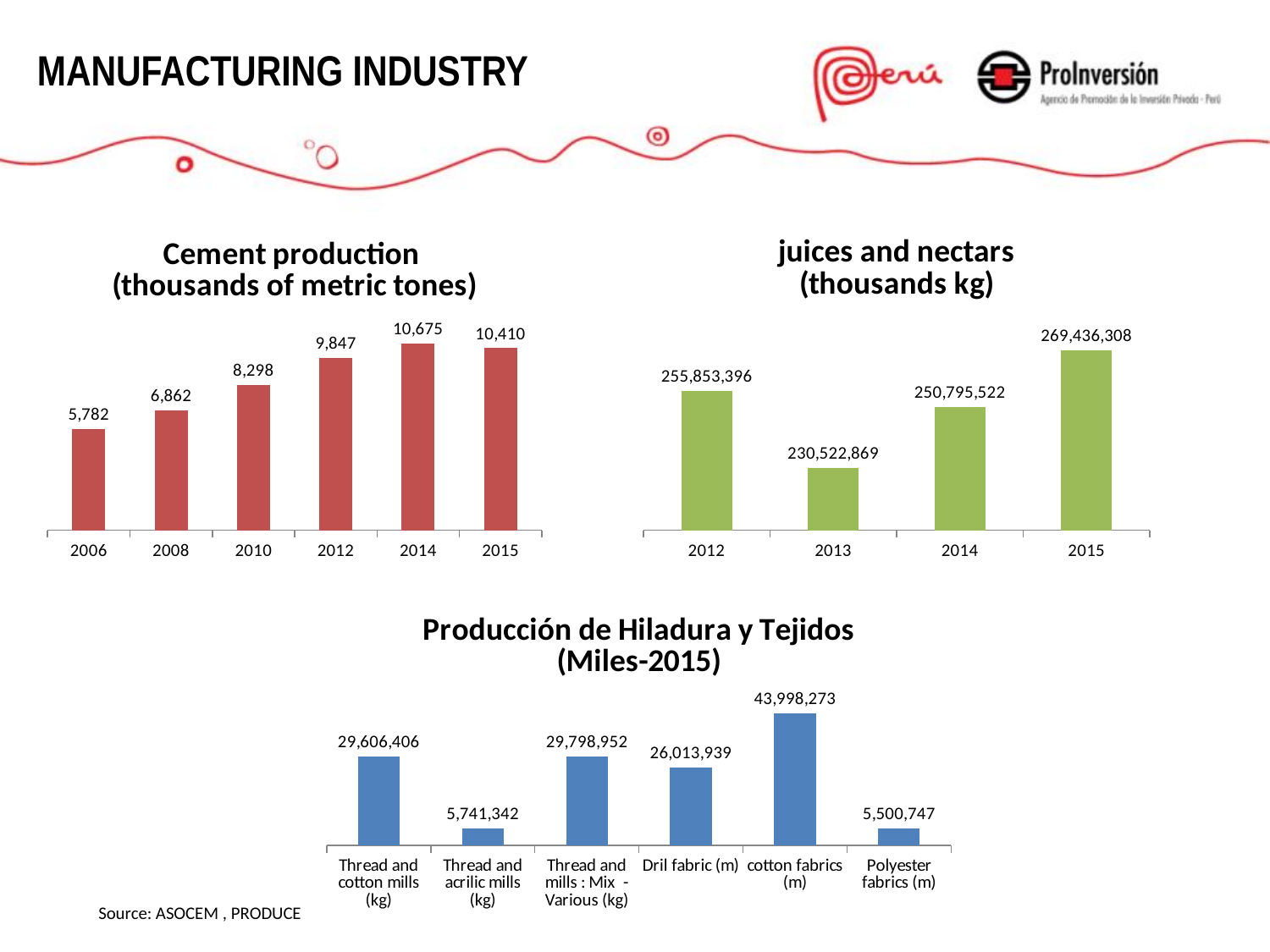
In the Cement production chart, which year has the highest value? 2014 In the Producción de Hiladura y Tejidos chart, what is the value for cotton fabrics (m)? 43,998,273 In the Cement production chart, what is the difference between the 2014 and 2015 values? 265 In the Cement production chart, how many years are shown? 6 In the juices and nectars chart, which year has the lowest value? 2013 In the juices and nectars chart, what is the value for 2013? 230,522,869 In the Producción de Hiladura y Tejidos chart, how many categories are shown? 6 What type of chart is the Cement production chart? Bar chart In the Cement production chart, what is the value for 2012? 9,847 In the Producción de Hiladura y Tejidos chart, which category has the lowest value? Polyester fabrics (m) In the juices and nectars chart, which is larger, the value for 2012 or the value for 2014? 2012 In the juices and nectars chart, what is the difference between the 2015 and 2012 values? 13,582,912